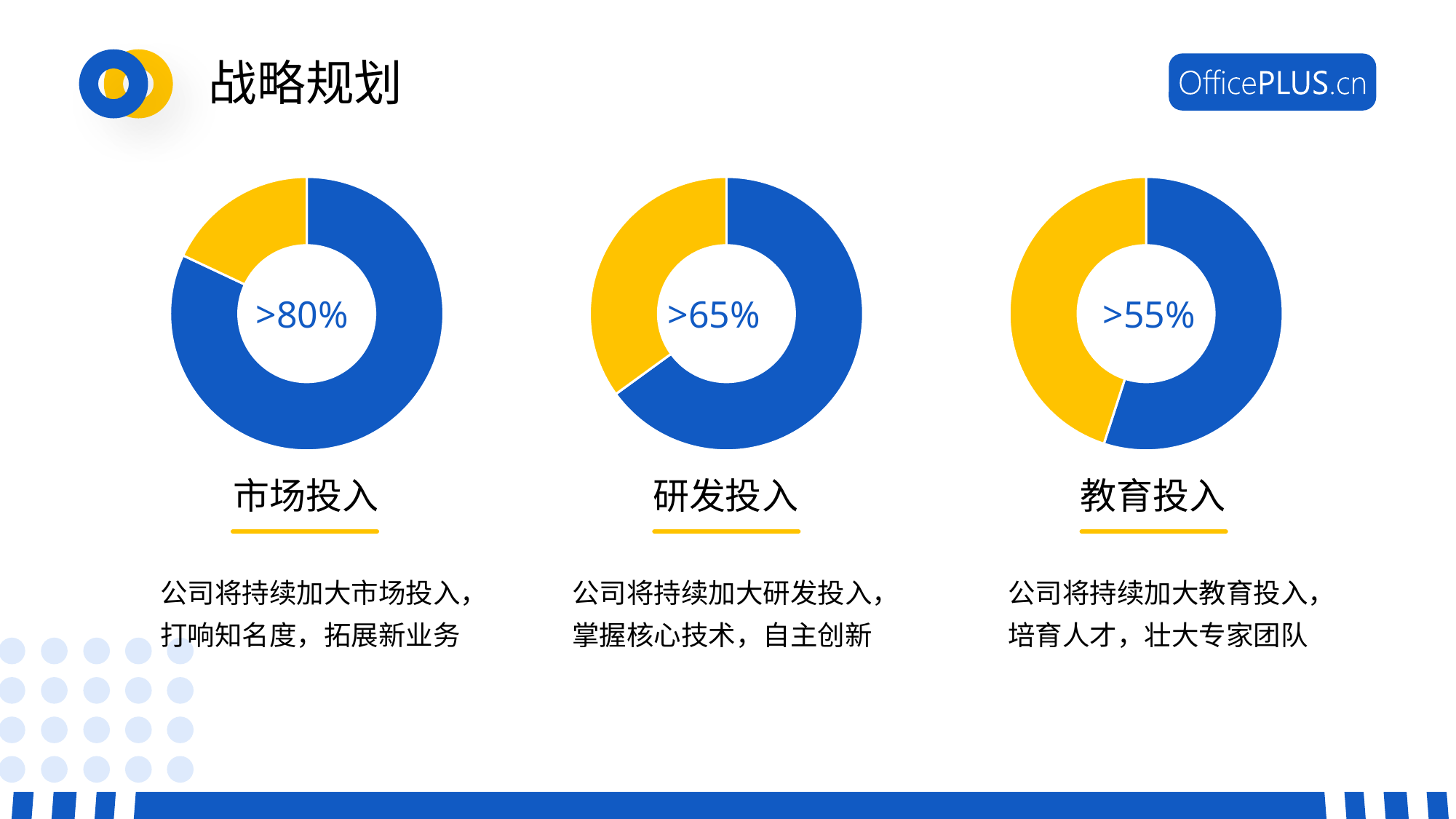
What value is shown in the centre of the 教育投入 donut chart? >55% What is the title of the slide containing the three donut charts? 战略规划 Which of the three donut charts shows the highest percentage? 市场投入 Which shows a higher percentage, the 研发投入 chart or the 教育投入 chart? 研发投入 What kind of chart is used for 市场投入, 研发投入 and 教育投入? Donut (pie) chart Which of the three donut charts shows the lowest percentage? 教育投入 How many donut charts are on the slide? 3 What value is shown in the centre of the 研发投入 donut chart? >65% In the 市场投入 donut chart, which slice is larger, the blue one or the yellow one? Blue In the 教育投入 donut chart, which slice is larger, the blue one or the yellow one? Blue What two colours are used for the slices in the donut charts? Blue and yellow What value is shown in the centre of the 市场投入 donut chart? >80%